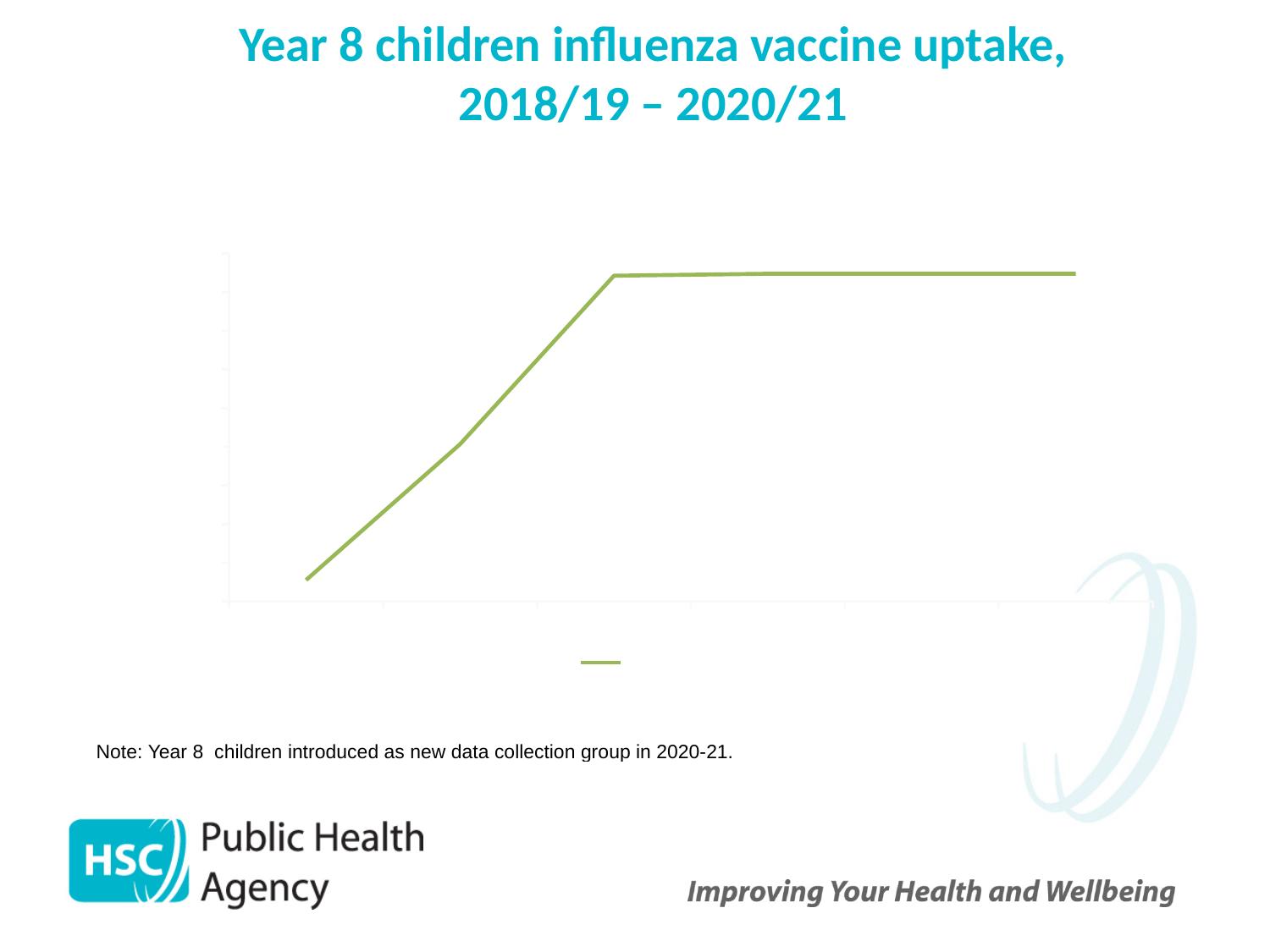
Does the line rise or fall from left to right across the chart? Rises, then levels off What colour is the plotted line? Green What kind of chart is shown on the slide? Line chart What is the title of the chart on the slide? Year 8 children influenza vaccine uptake, 2018/19 – 2020/21 How many series does the legend show? 1